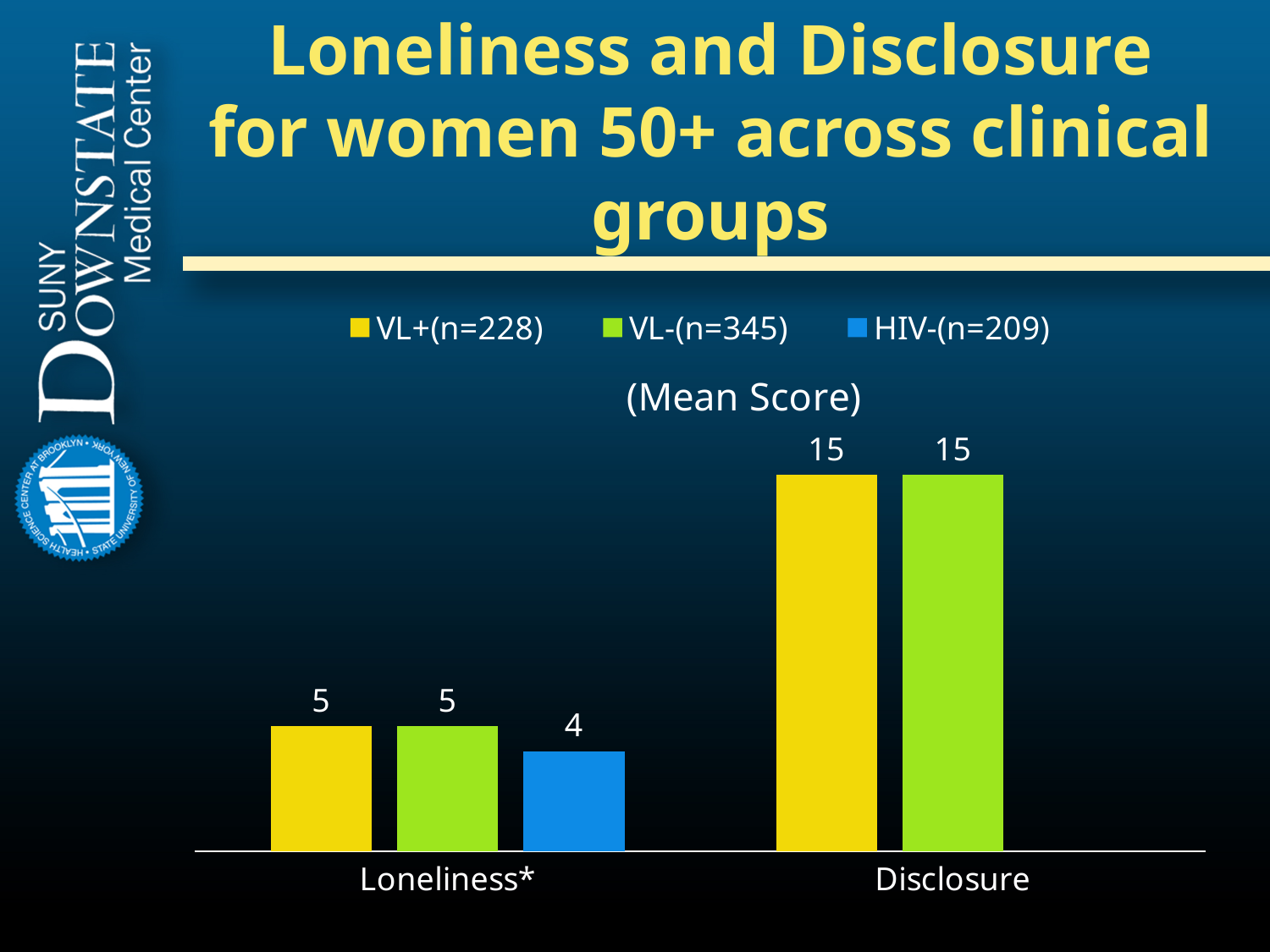
What is the difference between the VL+(n=228) Disclosure score and its Loneliness score? 10 How many categories are shown on the x axis? 2 What is the mean Loneliness score for the HIV-(n=209) group? 4 What is the mean Disclosure score for the VL-(n=345) group? 15 What is the mean Loneliness score for the VL+(n=228) group? 5 Which group has the lowest mean Loneliness score? HIV-(n=209) What is the difference between the VL+(n=228) and HIV-(n=209) mean Loneliness scores? 1 Which is larger: the VL-(n=345) Loneliness score or the HIV-(n=209) Loneliness score? VL-(n=345) Loneliness score What kind of chart is shown on the slide? Bar chart How many series does the legend list? 3 What is the mean Disclosure score for the VL+(n=228) group? 15 Which colour represents the HIV-(n=209) group in the legend? Blue